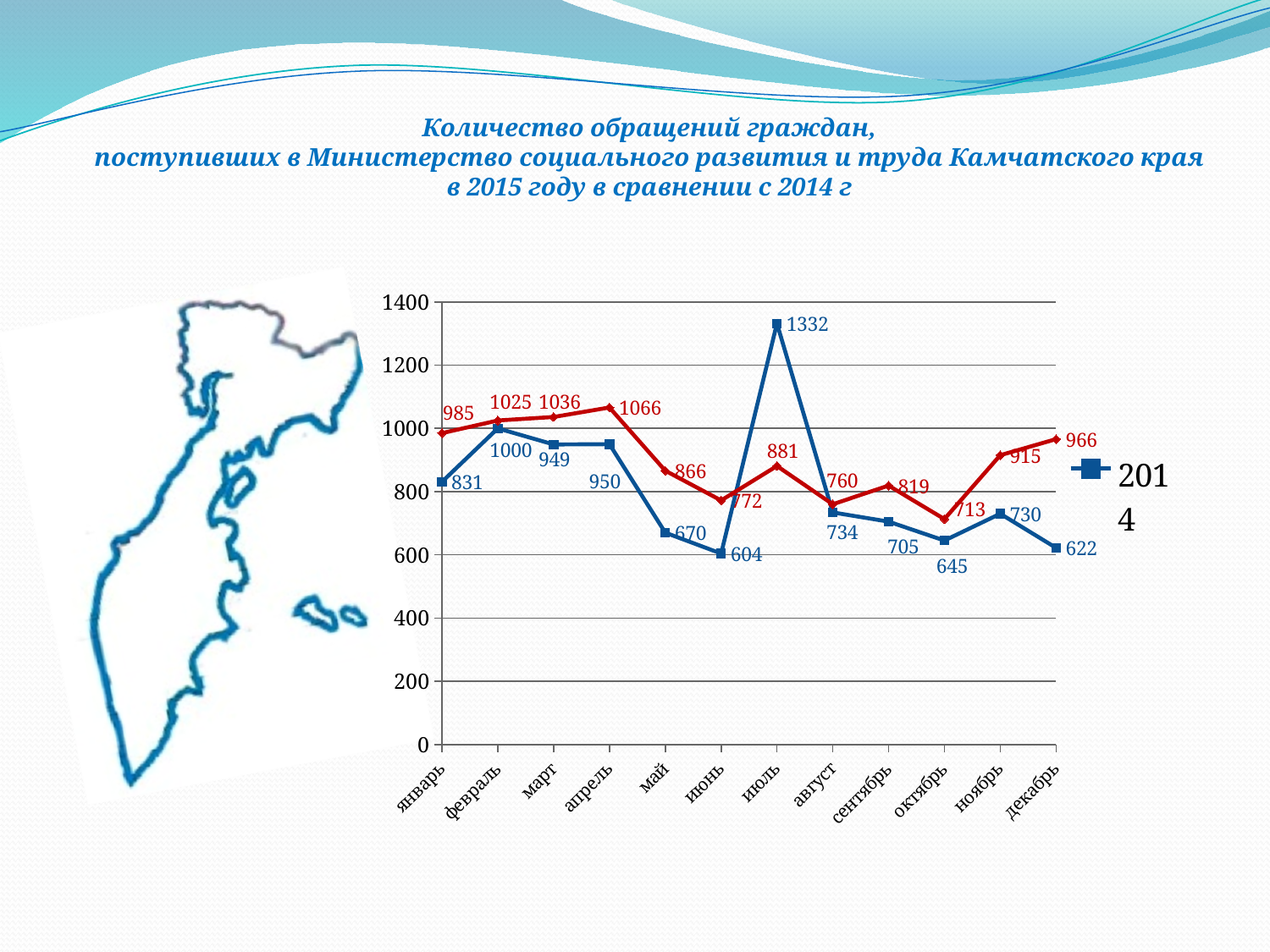
What is the difference between the blue 2014 value and the red value for июль? 451 What is the value of the blue 2014 series for октябрь? 645 What is the value of the blue 2014 series for июль? 1332 What is the value of the red series for апрель? 1066 For январь, which series has the higher value, the blue 2014 series or the red series? the red series What is the difference between the red value and the blue 2014 value for декабрь? 344 In which month does the red series reach its highest value? апрель What kind of chart is shown on the slide? line chart In which month does the red series have its lowest value? октябрь In which month does the blue 2014 series have its lowest value? июнь In which month does the blue 2014 series reach its highest value? июль How many months are shown on the x axis? 12